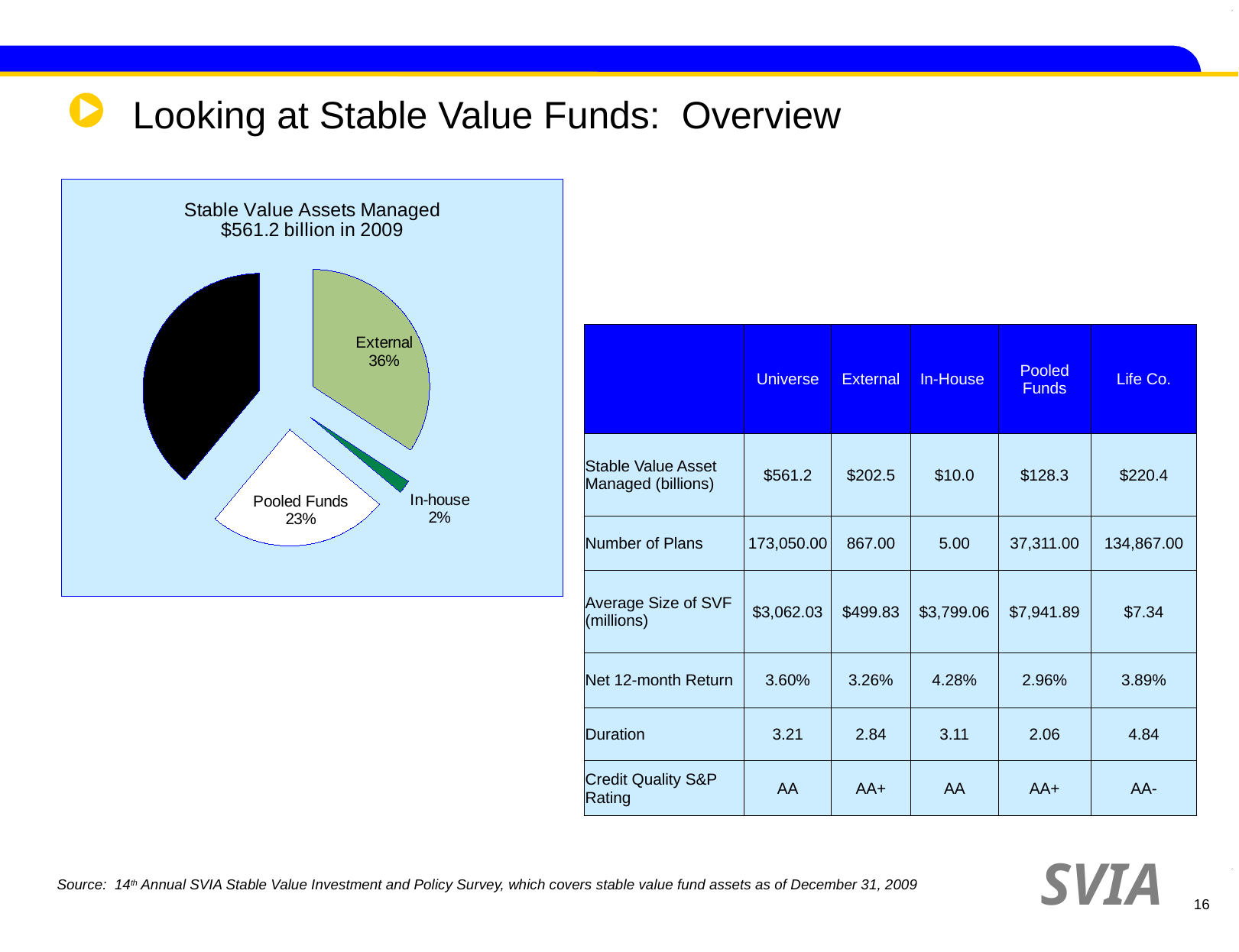
What is the difference in percentage points between the External and Pooled Funds slices? 13 What share of the pie does the Pooled Funds slice represent? 23% How many slices does the pie chart have? 4 What total dollar amount of stable value assets does the pie chart title state for 2009? $561.2 billion What is the difference in percentage points between the Pooled Funds and In-house slices? 21 What is the title of the pie chart? Stable Value Assets Managed $561.2 billion in 2009 What kind of chart is shown on the slide? pie chart Which labeled slice of the pie chart is the smallest? In-house What share of the pie does the External slice represent? 36% Which is larger in the pie chart, External or Pooled Funds? External What share of the pie does the In-house slice represent? 2% Which is larger in the pie chart, Pooled Funds or In-house? Pooled Funds